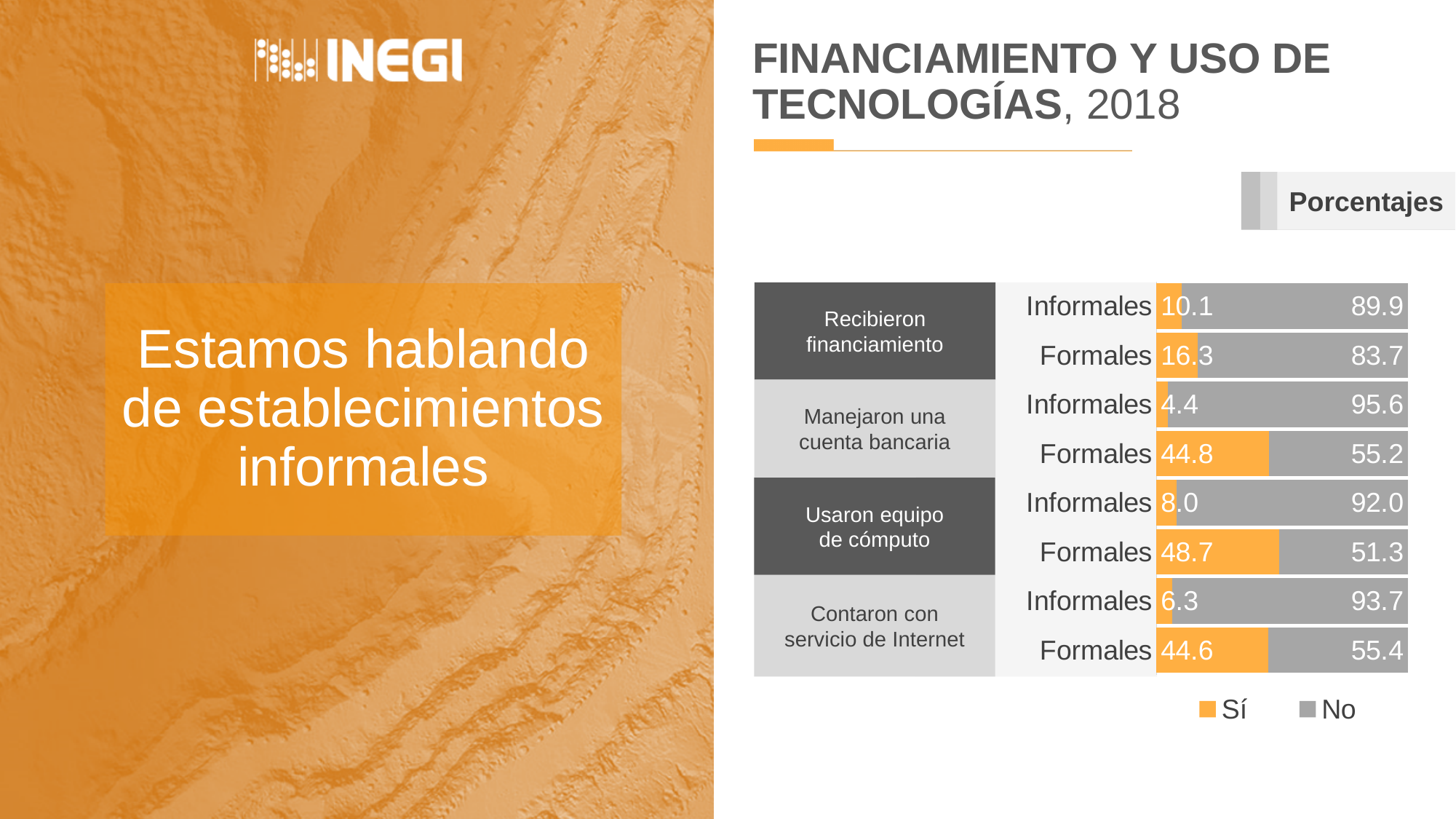
What is the Sí value for Formales under Usaron equipo de cómputo? 48.7 What is the difference between the Sí values for Formales and Informales under Manejaron una cuenta bancaria? 40.4 What percentage of informal establishments (Informales) received financing (Recibieron financiamiento), according to the Sí series? 10.1 Which bar has the highest Sí value? Formales, Usaron equipo de cómputo What is the No value for Informales under Contaron con servicio de Internet? 93.7 How many series does the legend list? 2 What kind of chart is shown on the slide? Stacked bar chart How many bars are plotted in the chart? 8 Which bar has the lowest Sí value? Informales, Manejaron una cuenta bancaria What is the total of the Sí and No values for Informales under Usaron equipo de cómputo? 100.0 Which is larger: the Sí value for Formales under Recibieron financiamiento or the Sí value for Formales under Contaron con servicio de Internet? Formales under Contaron con servicio de Internet What is the No value for formal establishments (Formales) under Manejaron una cuenta bancaria? 55.2